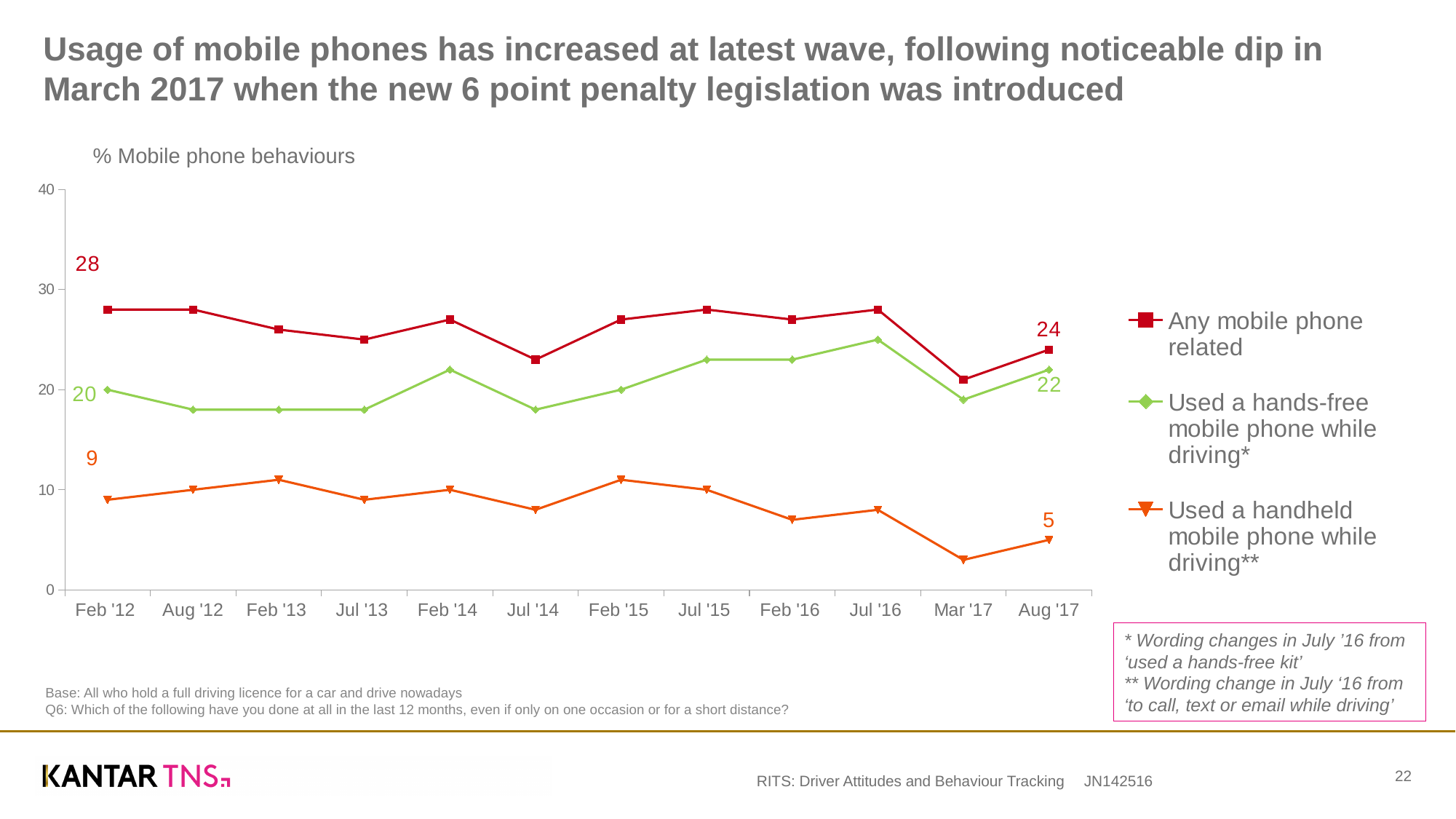
What is the value for 'Any mobile phone related' at Feb '12? 28 Is the value for 'Used a handheld mobile phone while driving**' at Mar '17 greater or less than 10? less Is the value for 'Any mobile phone related' at Jul '15 greater or less than 20? greater What kind of chart is shown on the slide? Line chart How many series does the legend list? 3 At Aug '17, which is larger: 'Any mobile phone related' or 'Used a hands-free mobile phone while driving*'? Any mobile phone related What is the value for 'Used a handheld mobile phone while driving**' at Aug '17? 5 What is the value for 'Used a handheld mobile phone while driving**' at Feb '12? 9 By how much did 'Any mobile phone related' change between Feb '12 and Aug '17? 4 What is the difference between 'Any mobile phone related' and 'Used a hands-free mobile phone while driving*' at Aug '17? 2 How many time points are shown on the x axis? 12 What is the value for 'Used a hands-free mobile phone while driving*' at Aug '17? 22